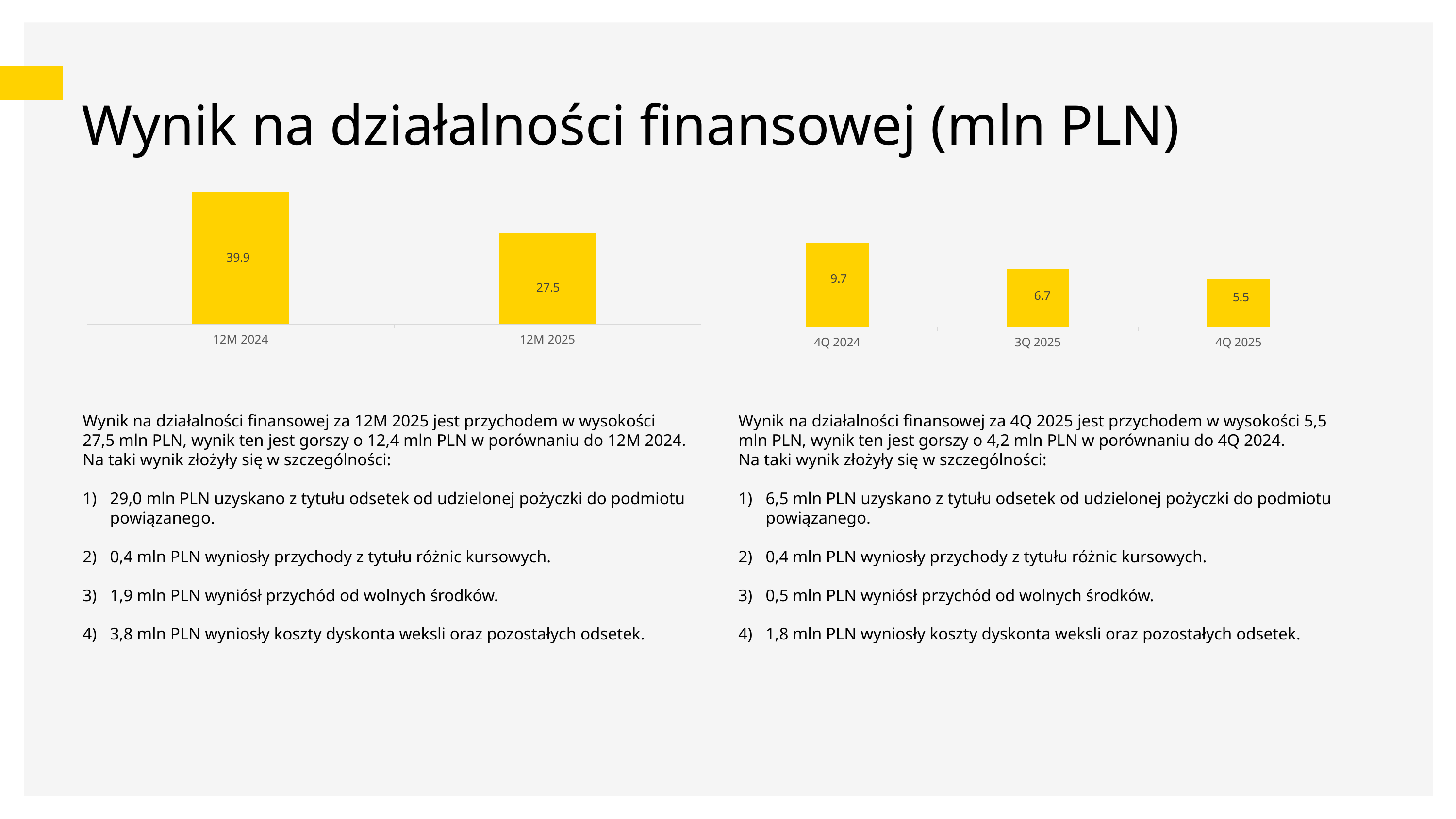
In the right chart, what is the difference between the values for 4Q 2024 and 4Q 2025? 4.2 In the right chart, what is the value for 4Q 2024? 9.7 In the right chart, which period has the highest value? 4Q 2024 In the left chart, what is the value for 12M 2025? 27.5 In the right chart, which is larger, the value for 3Q 2025 or 4Q 2025? 3Q 2025 How many bars does the right chart show? 3 In the right chart, what is the value for 4Q 2025? 5.5 In the left chart, what is the difference between the values for 12M 2024 and 12M 2025? 12.4 What type of chart is the left chart? Bar chart In the right chart, what is the value for 3Q 2025? 6.7 In the left chart, what is the value for 12M 2024? 39.9 In the right chart, which period has the lowest value? 4Q 2025